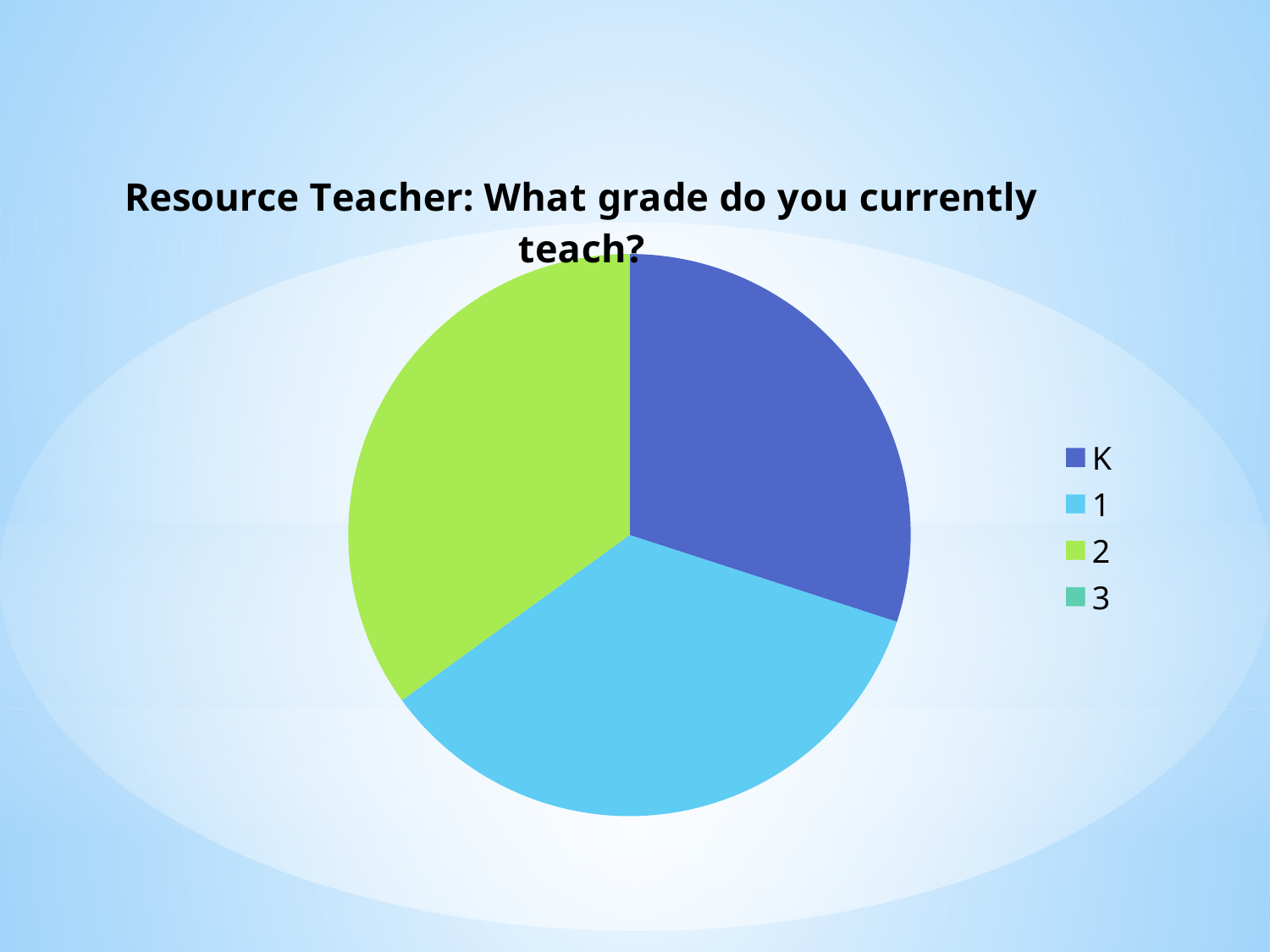
What kind of chart is shown on the slide? pie chart How many entries does the legend list? 4 Which legend entry has no visible slice in the pie? 3 Is the slice for K greater or less than 50% of the pie? less Is the slice for 2 greater or less than 50% of the pie? less Is the slice for 1 greater or less than 50% of the pie? less How many slices are visible in the pie chart? 3 What is the title of the chart? Resource Teacher: What grade do you currently teach?